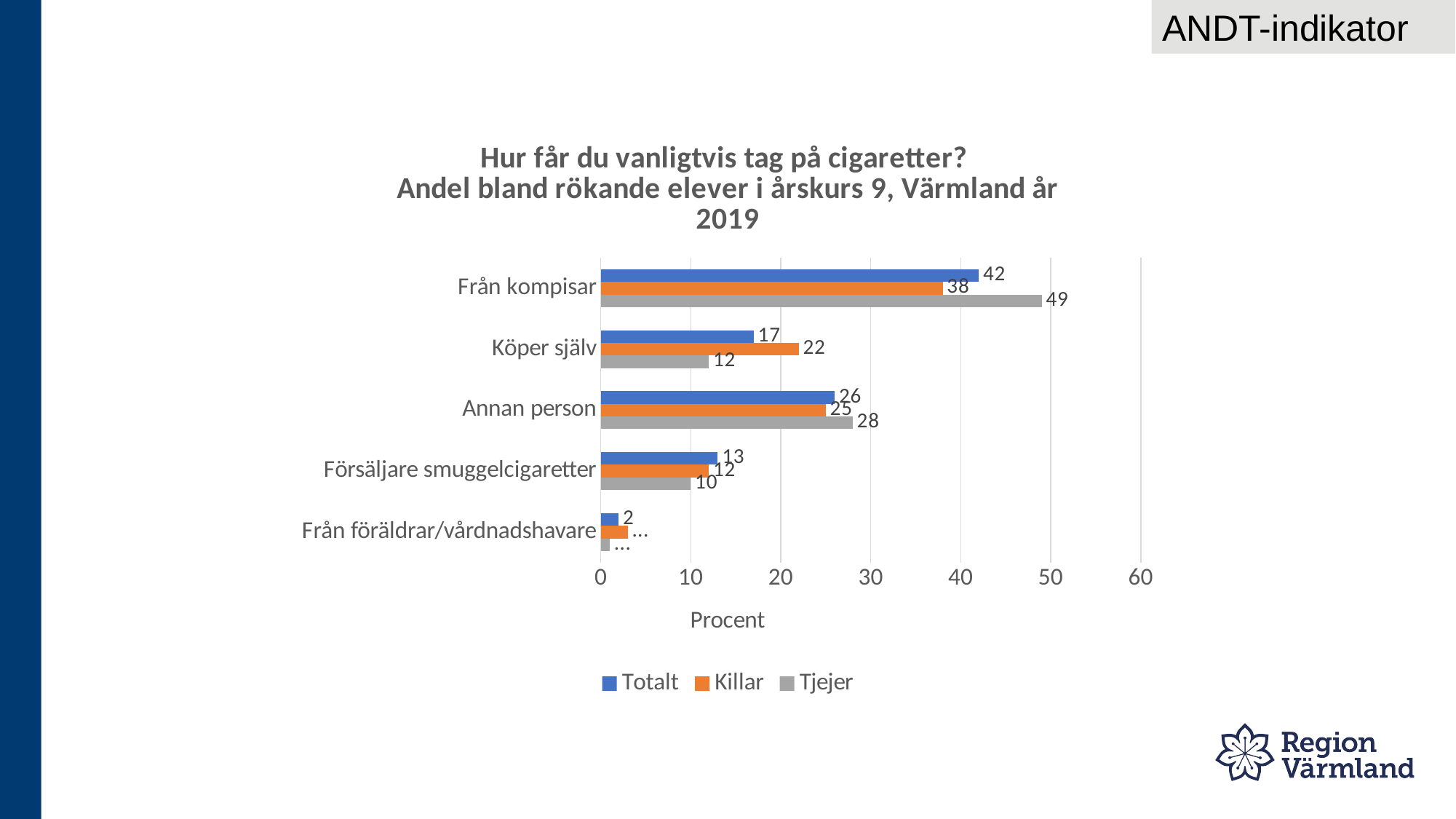
What is the difference between the Tjejer and Killar values for Från kompisar? 11 Which category has the highest Tjejer value? Från kompisar What is the label of the horizontal axis? Procent What is the Tjejer value for Köper själv? 12 How many series does the legend list? 3 Is the Totalt value for Annan person greater or less than 20? greater For Köper själv, which is larger, the Killar value or the Tjejer value? Killar Which category has the lowest Totalt value? Från föräldrar/vårdnadshavare How many categories are shown on the chart? 5 What is the Killar value for Annan person? 25 What is the Totalt value for Från kompisar? 42 What kind of chart is shown on the slide? Bar chart